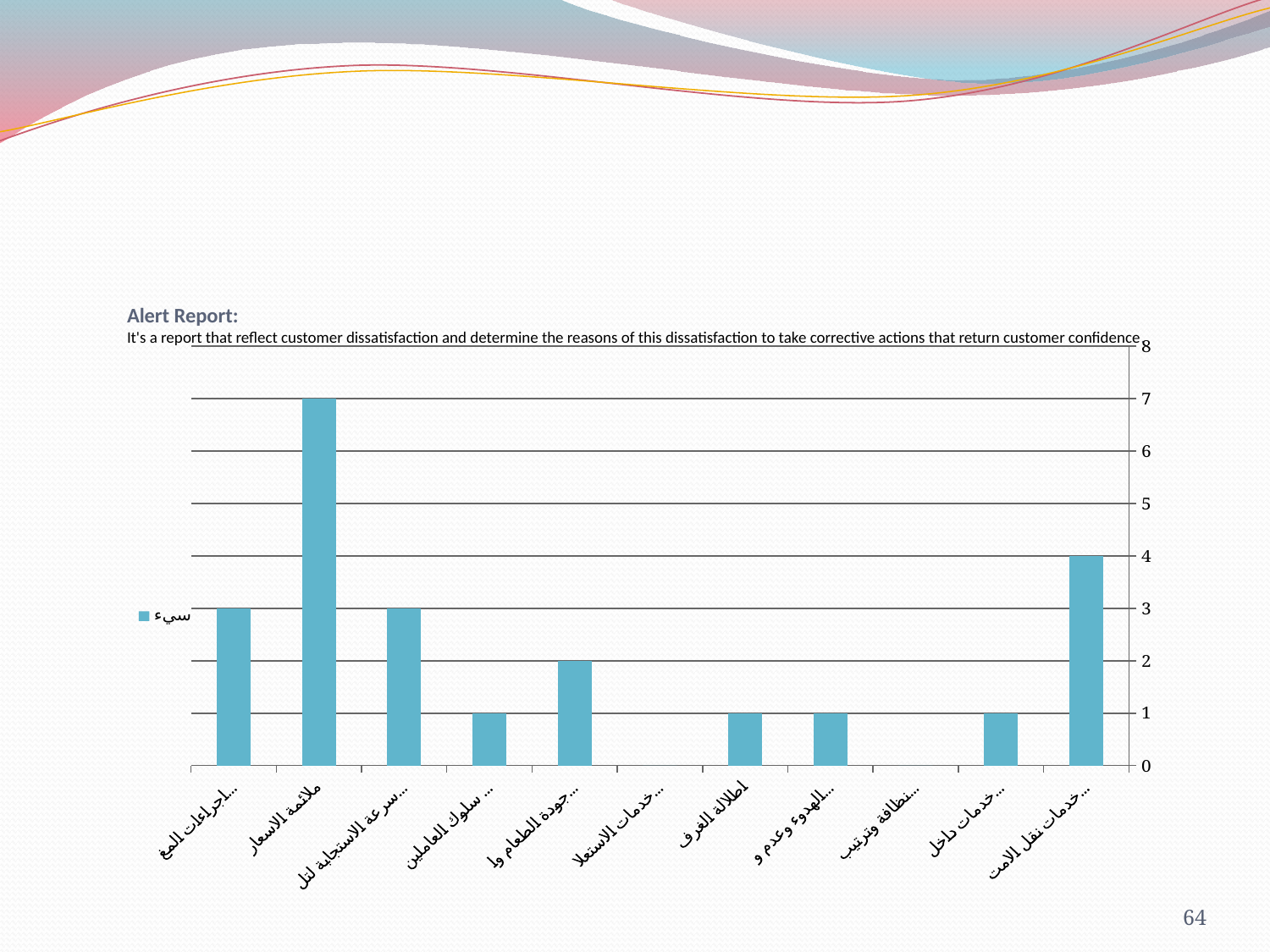
How many categories are shown on the x axis of the chart? 11 What is the legend entry for the series in the chart? سيء What type of chart is shown on the slide? bar chart What is the highest value shown on the vertical axis? 8 What is the value of the last (rightmost) bar, خدمات نقل الامت...? 4 Which category has the highest value? ملائمة الاسعار What is the value for ملائمة الاسعار? 7 What is the difference between the value for ملائمة الاسعار and the value for اطلالة الغرف? 6 What is the value for اطلالة الغرف? 1 How many series does the legend list? 1 Which is larger, the value for ملائمة الاسعار or the value for the rightmost bar (خدمات نقل الامت...)? ملائمة الاسعار Is the value for ملائمة الاسعار greater or less than 5? greater